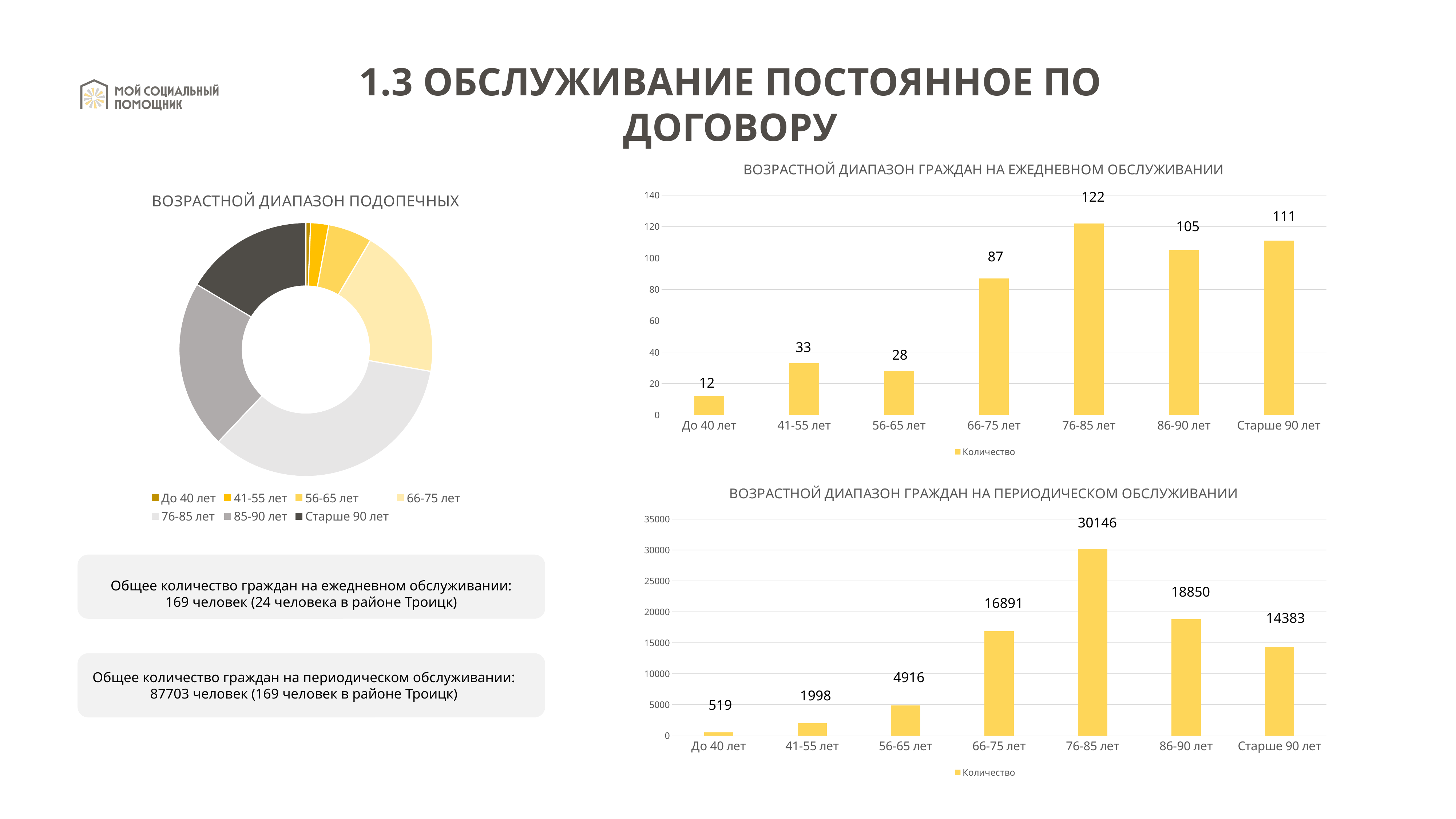
In the chart 'ВОЗРАСТНОЙ ДИАПАЗОН ГРАЖДАН НА ПЕРИОДИЧЕСКОМ ОБСЛУЖИВАНИИ', is the value for 'Старше 90 лет' greater or less than 15000? less In the chart 'ВОЗРАСТНОЙ ДИАПАЗОН ГРАЖДАН НА ЕЖЕДНЕВНОМ ОБСЛУЖИВАНИИ', which age category has the highest value? 76-85 лет What kind of chart is 'ВОЗРАСТНОЙ ДИАПАЗОН ПОДОПЕЧНЫХ' on the left of the slide? Donut (pie) chart In the chart 'ВОЗРАСТНОЙ ДИАПАЗОН ГРАЖДАН НА ЕЖЕДНЕВНОМ ОБСЛУЖИВАНИИ', what is the value for '66-75 лет'? 87 How many age categories are shown in the chart 'ВОЗРАСТНОЙ ДИАПАЗОН ГРАЖДАН НА ЕЖЕДНЕВНОМ ОБСЛУЖИВАНИИ'? 7 In the chart 'ВОЗРАСТНОЙ ДИАПАЗОН ГРАЖДАН НА ПЕРИОДИЧЕСКОМ ОБСЛУЖИВАНИИ', what is the difference between the values for '66-75 лет' and '56-65 лет'? 11975 In the chart 'ВОЗРАСТНОЙ ДИАПАЗОН ГРАЖДАН НА ЕЖЕДНЕВНОМ ОБСЛУЖИВАНИИ', which is larger: the value for '41-55 лет' or '56-65 лет'? 41-55 лет In the chart 'ВОЗРАСТНОЙ ДИАПАЗОН ГРАЖДАН НА ЕЖЕДНЕВНОМ ОБСЛУЖИВАНИИ', what is the difference between the values for '76-85 лет' and '86-90 лет'? 17 How many series does the legend of the chart 'ВОЗРАСТНОЙ ДИАПАЗОН ГРАЖДАН НА ПЕРИОДИЧЕСКОМ ОБСЛУЖИВАНИИ' list? 1 In the chart 'ВОЗРАСТНОЙ ДИАПАЗОН ГРАЖДАН НА ЕЖЕДНЕВНОМ ОБСЛУЖИВАНИИ', which age category has the lowest value? До 40 лет In the chart 'ВОЗРАСТНОЙ ДИАПАЗОН ГРАЖДАН НА ПЕРИОДИЧЕСКОМ ОБСЛУЖИВАНИИ', what is the value for '86-90 лет'? 18850 In the chart 'ВОЗРАСТНОЙ ДИАПАЗОН ГРАЖДАН НА ПЕРИОДИЧЕСКОМ ОБСЛУЖИВАНИИ', which age category has the highest value? 76-85 лет